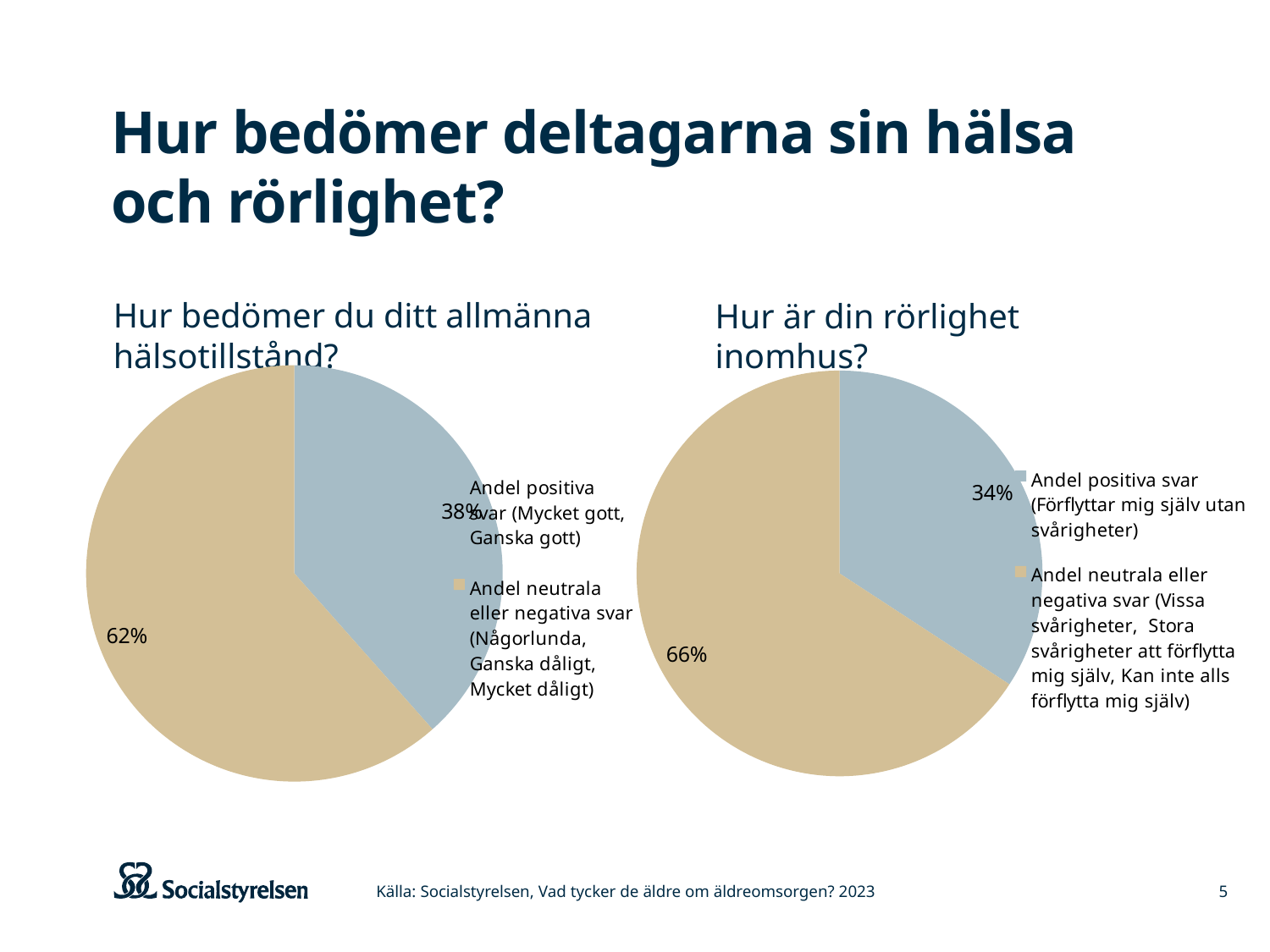
In the right chart (Hur är din rörlighet inomhus?), what share of answers are neutral or negative? 66% How many slices does the right chart (Hur är din rörlighet inomhus?) have? 2 In the left chart (Hur bedömer du ditt allmänna hälsotillstånd?), what is the difference in percentage points between the neutral/negative share and the positive share? 24 percentage points In the right chart (Hur är din rörlighet inomhus?), which category has the smallest slice? Andel positiva svar In the left chart (Hur bedömer du ditt allmänna hälsotillstånd?), what share of answers are neutral or negative? 62% Which chart shows a larger share of positive answers, the left chart (allmänna hälsotillstånd) or the right chart (rörlighet inomhus)? The left chart (allmänna hälsotillstånd) What type of chart is used on this slide? Pie chart In the right chart (Hur är din rörlighet inomhus?), what is the difference in percentage points between the neutral/negative share and the positive share? 32 percentage points In the left chart (Hur bedömer du ditt allmänna hälsotillstånd?), what share of answers are positive (Mycket gott, Ganska gott)? 38% In the left chart (Hur bedömer du ditt allmänna hälsotillstånd?), which category has the largest slice? Andel neutrala eller negativa svar In the right chart (Hur är din rörlighet inomhus?), what share of answers are positive (Förflyttar mig själv utan svårigheter)? 34% What is the title of the left chart? Hur bedömer du ditt allmänna hälsotillstånd?